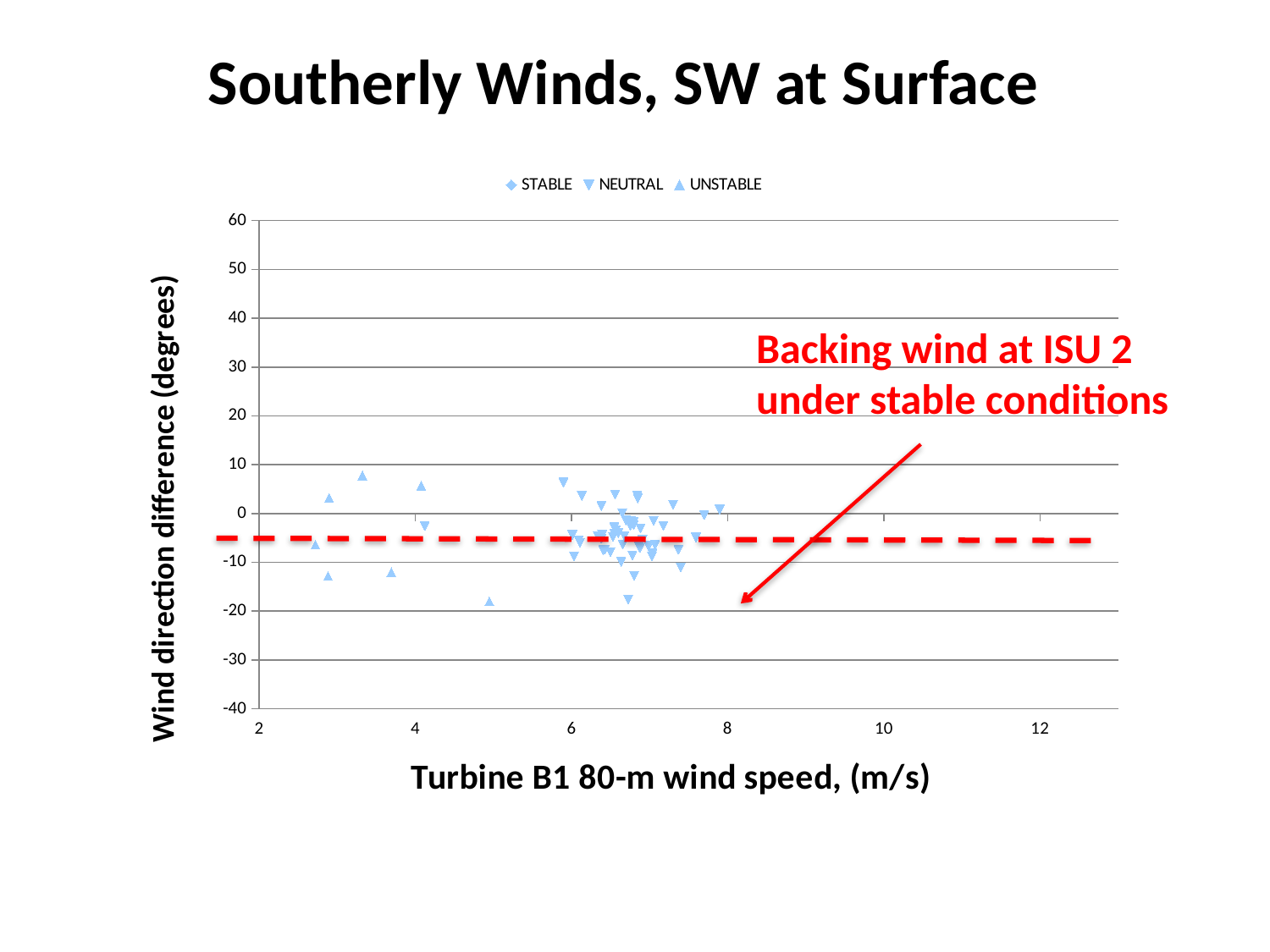
Is the lowest plotted wind direction difference greater or less than -10? less Is the highest plotted wind direction difference greater or less than 10? less How many series does the legend list? 3 What kind of chart is shown on the slide? scatter chart What are the three series named in the legend? STABLE, NEUTRAL, UNSTABLE Is the highest plotted wind direction difference greater or less than 0? greater What is the title of the chart's x axis? Turbine B1 80-m wind speed, (m/s)